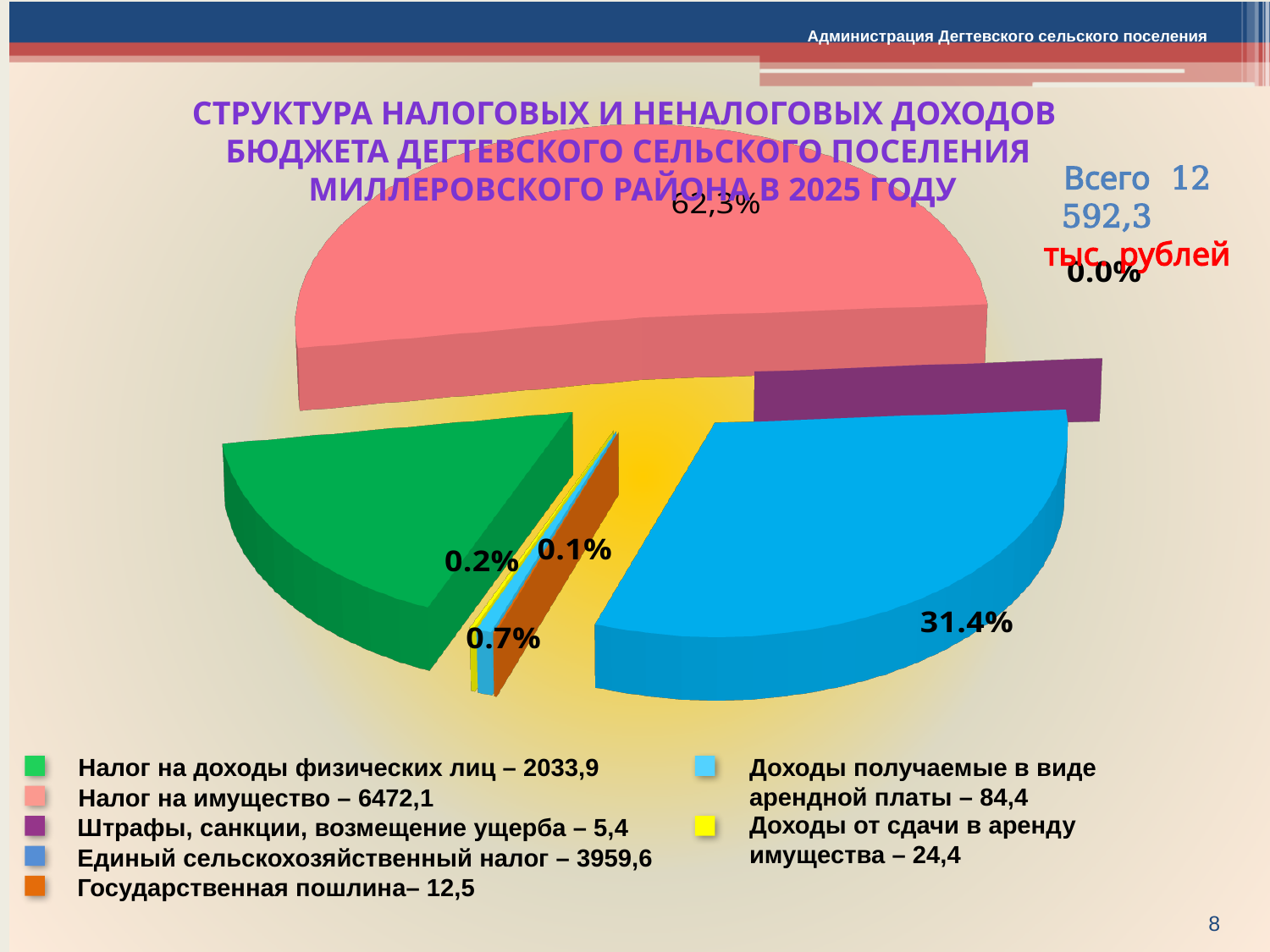
What value is given for Единый сельскохозяйственный налог? 3959,6 Which category has the lowest value? Штрафы, санкции, возмещение ущерба What percentage label is shown on the blue slice for Единый сельскохозяйственный налог? 31.4% Which category has the highest value? Налог на имущество What value is given for Государственная пошлина? 12,5 How many categories does the legend of the pie chart list? 7 What is the difference between the values for Налог на имущество and Единый сельскохозяйственный налог? 2512,5 What total amount (Всего) is stated on the slide? 12 592,3 тыс. рублей What value is given for Налог на имущество? 6472,1 Which is larger: Налог на доходы физических лиц or Единый сельскохозяйственный налог? Единый сельскохозяйственный налог What percentage label is shown on the largest (pink) slice of the pie? 62,3% What type of chart is shown on the slide? pie chart